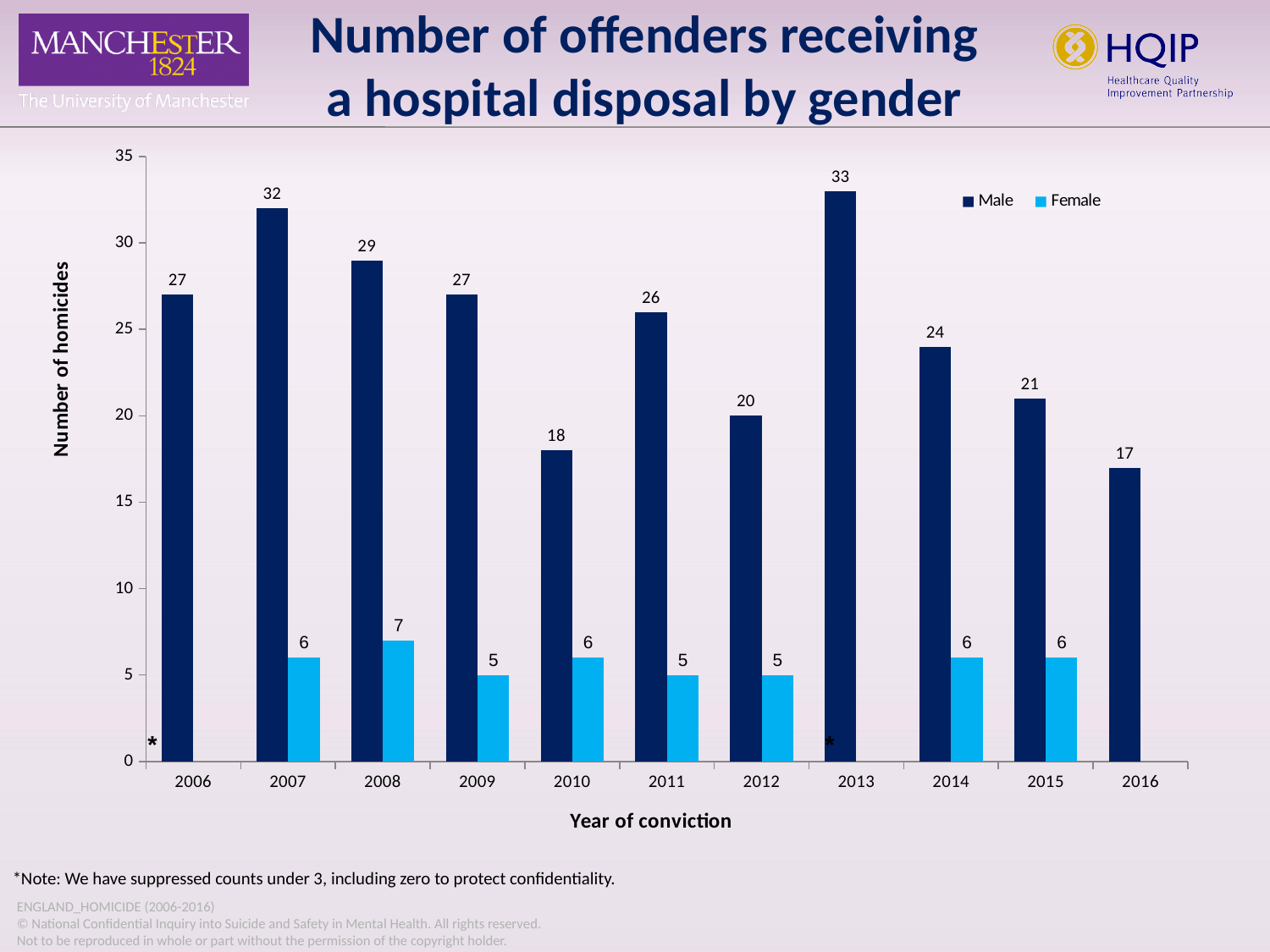
Which year has the larger Male value, 2008 or 2014? 2008 Is the Male value for 2011 greater or less than 25? greater What is the difference between the Male values for 2007 and 2010? 14 In which year of conviction is the Male value lowest? 2016 In which year of conviction is the Female value highest? 2008 How many series does the legend list? 2 What kind of chart is shown on the slide? Bar chart How many years of conviction are shown on the x axis? 11 What is the number of female offenders receiving a hospital disposal in 2008? 7 What is the number of male offenders receiving a hospital disposal in 2013? 33 What is the combined Male and Female value for 2007? 38 In which year of conviction is the Male value highest? 2013